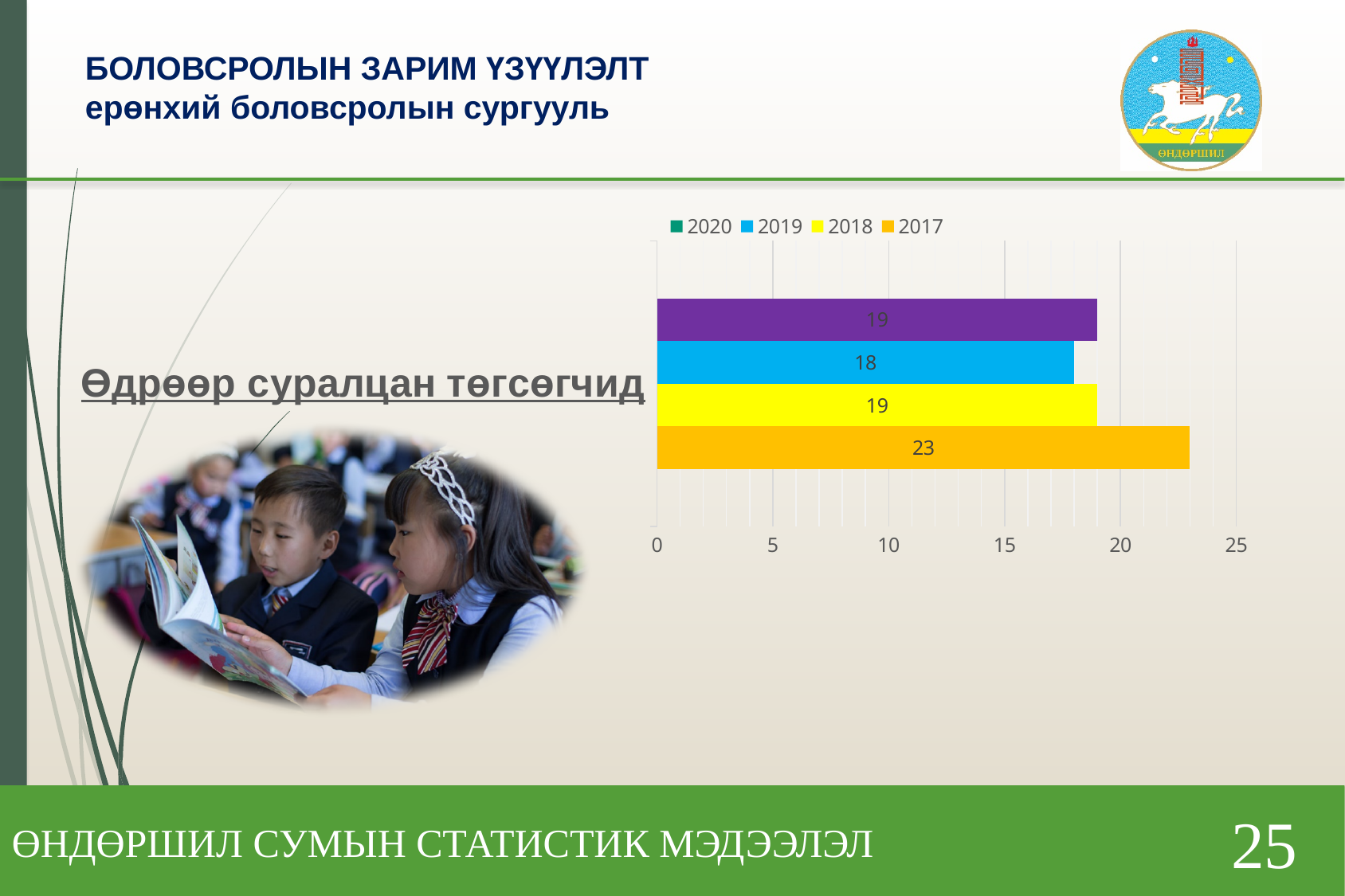
What is the value of the 2017 bar? 23 What is the value of the 2019 bar? 18 How many bars are plotted in the chart? 4 Which years are listed in the chart legend? 2020, 2019, 2018, 2017 How many series does the chart legend list? 4 What is the difference between the 2017 value and the 2019 value? 5 Which year has the lowest value in the chart? 2019 Which is larger, the value for 2018 or the value for 2019? 2018 Which year has the highest value in the chart? 2017 Is the value for 2017 greater or less than 20? greater What type of chart is shown on the slide? bar chart What is the value of the 2018 bar? 19